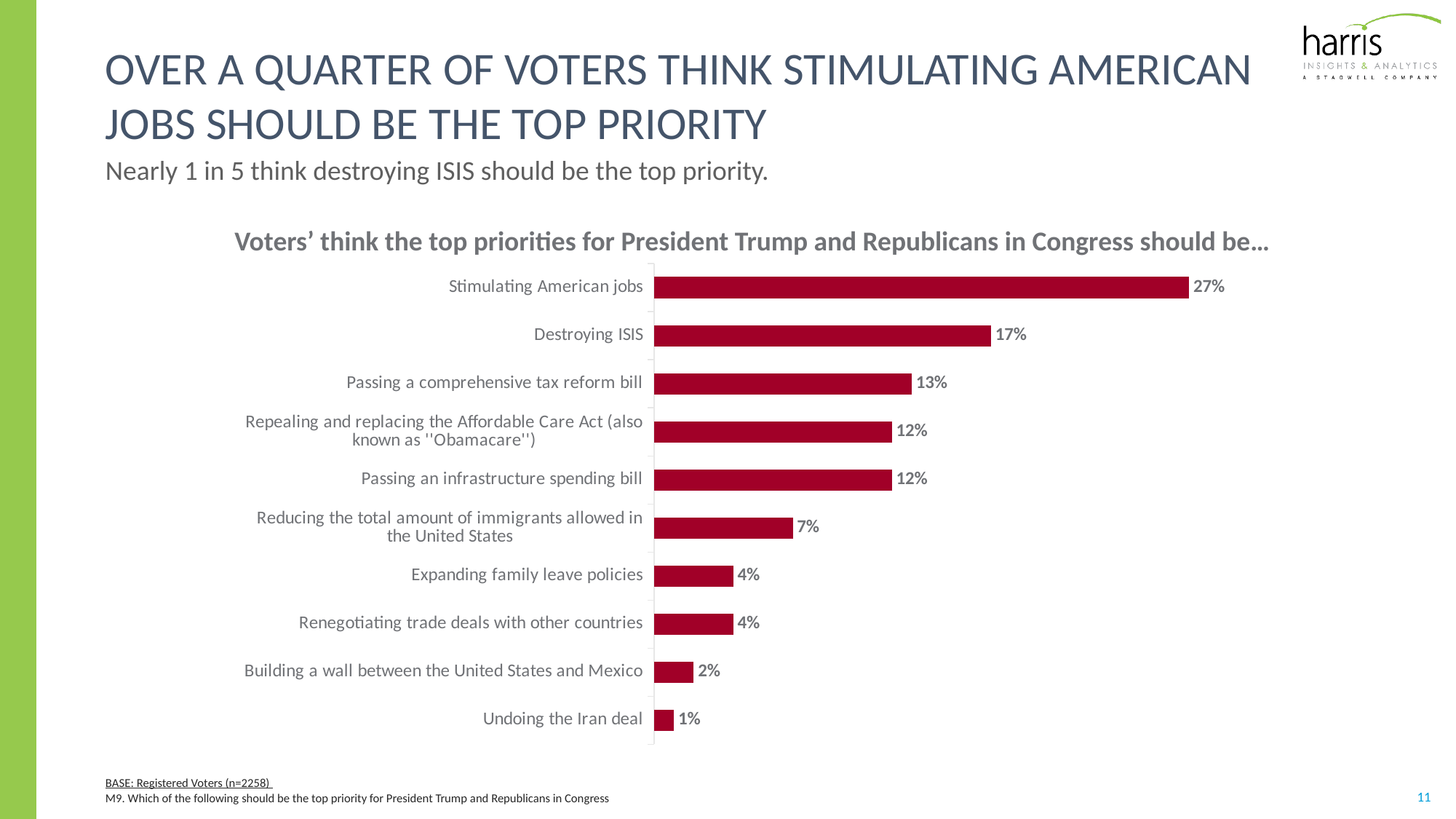
What is the difference between the values for Stimulating American jobs and Destroying ISIS? 10% What is the value for Destroying ISIS? 17% Which is larger: the value for Destroying ISIS or the value for Passing an infrastructure spending bill? Destroying ISIS Which priority has the highest percentage? Stimulating American jobs What is the difference between Passing a comprehensive tax reform bill and Reducing the total amount of immigrants allowed in the United States? 6% What is the title of the chart? Voters' think the top priorities for President Trump and Republicans in Congress should be… What type of chart is shown on the slide? Bar chart Which priority has the lowest percentage? Undoing the Iran deal What percentage of voters think stimulating American jobs should be the top priority? 27% What percentage is shown for Passing a comprehensive tax reform bill? 13% How many priorities are shown in the chart? 10 What is the value for Building a wall between the United States and Mexico? 2%